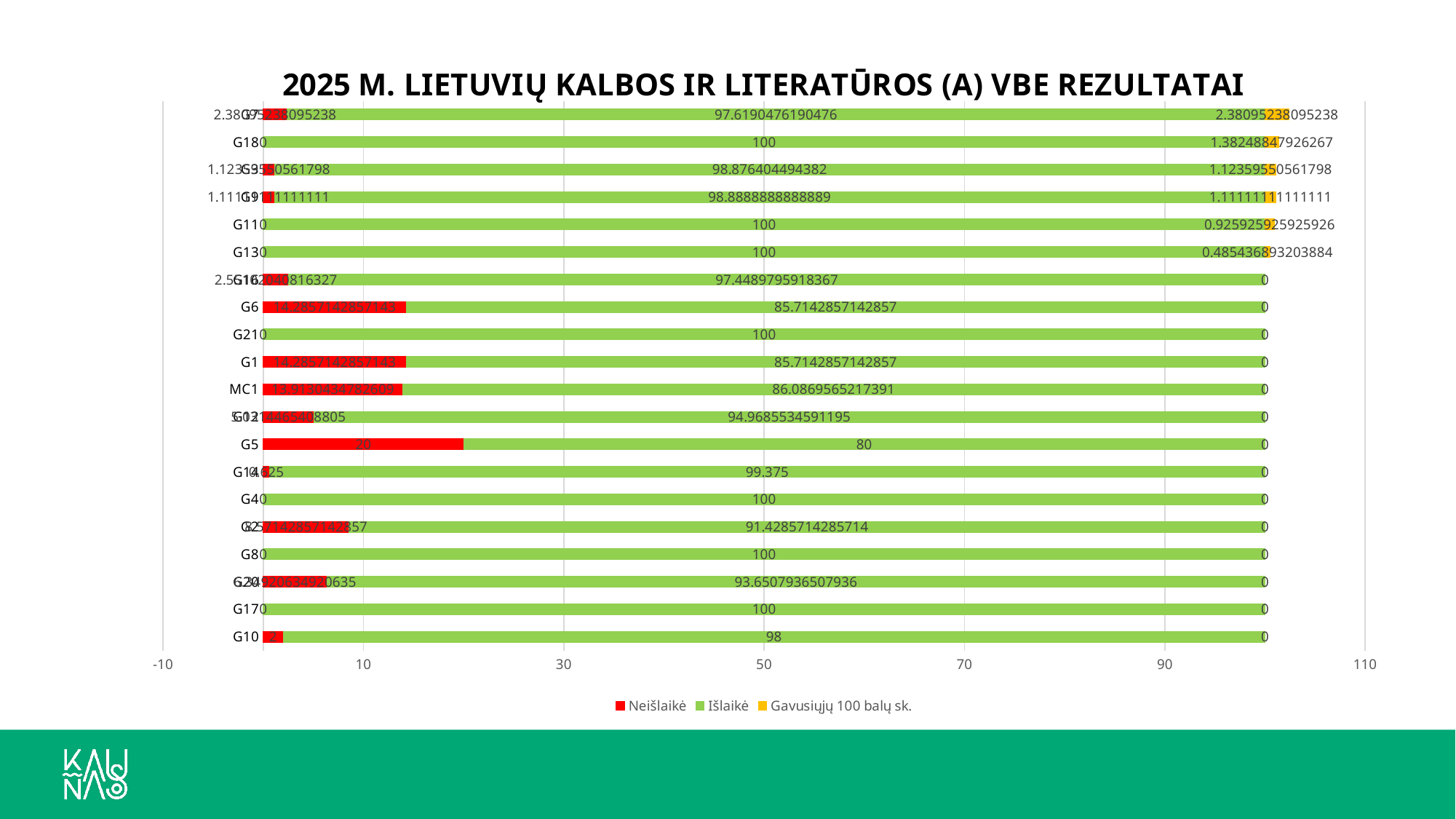
What is the Išlaikė value for G10? 98 How many categories (bars) are plotted in the chart? 20 What is the difference between the Išlaikė values for G10 and G5? 18 Which category has the highest Neišlaikė value? G5 How many series does the legend list? 3 What is the Išlaikė value for G5? 80 What is the total of the stacked bar for G5? 100 Which has the larger Neišlaikė value, G6 or G10? G6 What is the Išlaikė value for MC1? 86.0869565217391 What kind of chart is shown on the slide? bar chart What is the Neišlaikė value for G5? 20